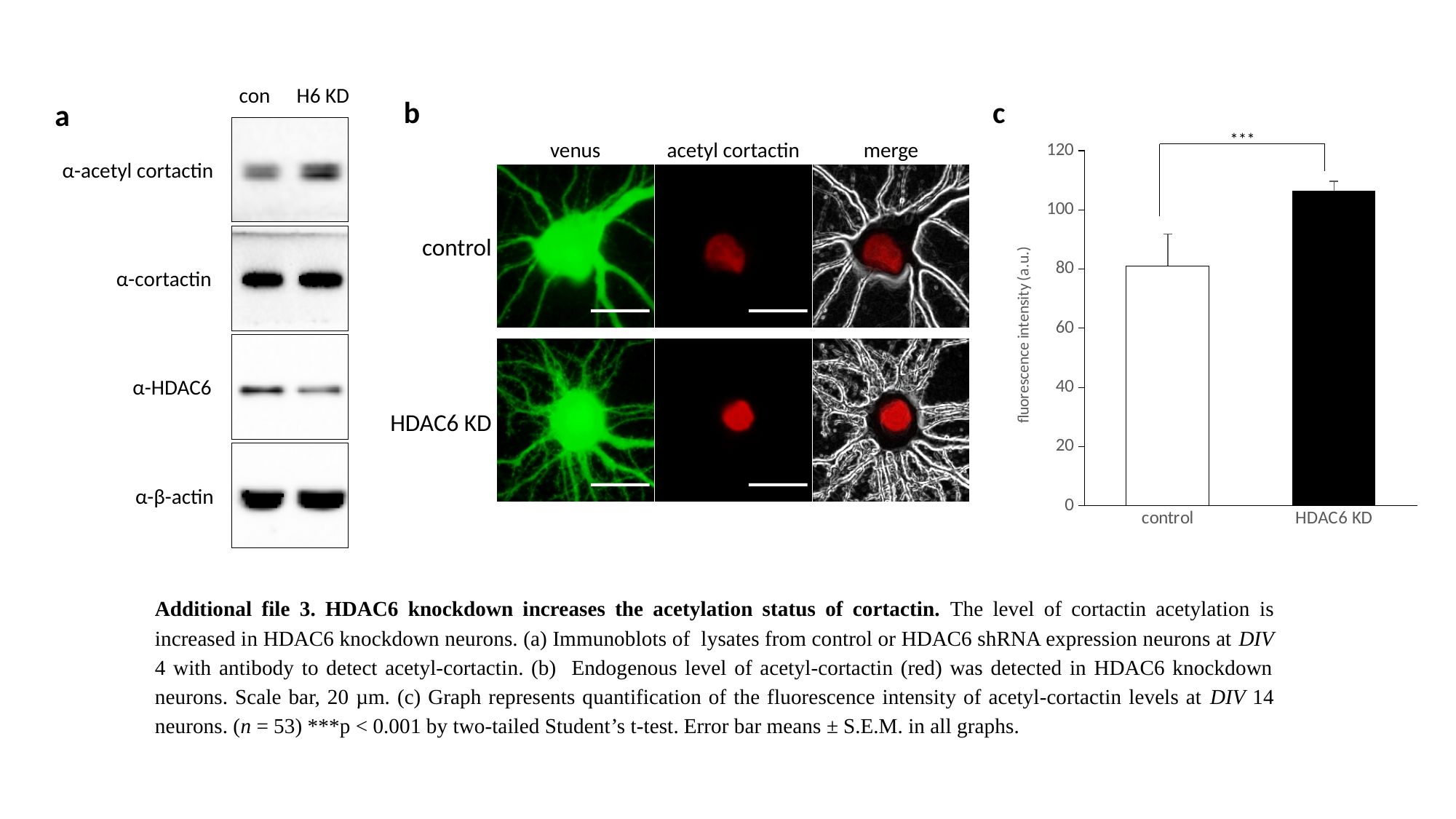
In the bar chart in panel c, which category has the highest fluorescence intensity? HDAC6 KD In the bar chart in panel c, what colour is the HDAC6 KD bar? black In the bar chart in panel c, is the value for control greater or less than 60? greater In the bar chart in panel c, is the value for HDAC6 KD greater or less than 120? less What kind of chart is shown in panel c? bar chart In the bar chart in panel c, which category has the lowest fluorescence intensity? control In the bar chart in panel c, which is larger, the value for control or the value for HDAC6 KD? HDAC6 KD In the bar chart in panel c, how many categories are plotted on the x axis? 2 In the bar chart in panel c, is the value for control greater or less than 100? less What is the y-axis label of the bar chart in panel c? fluorescence intensity (a.u.)